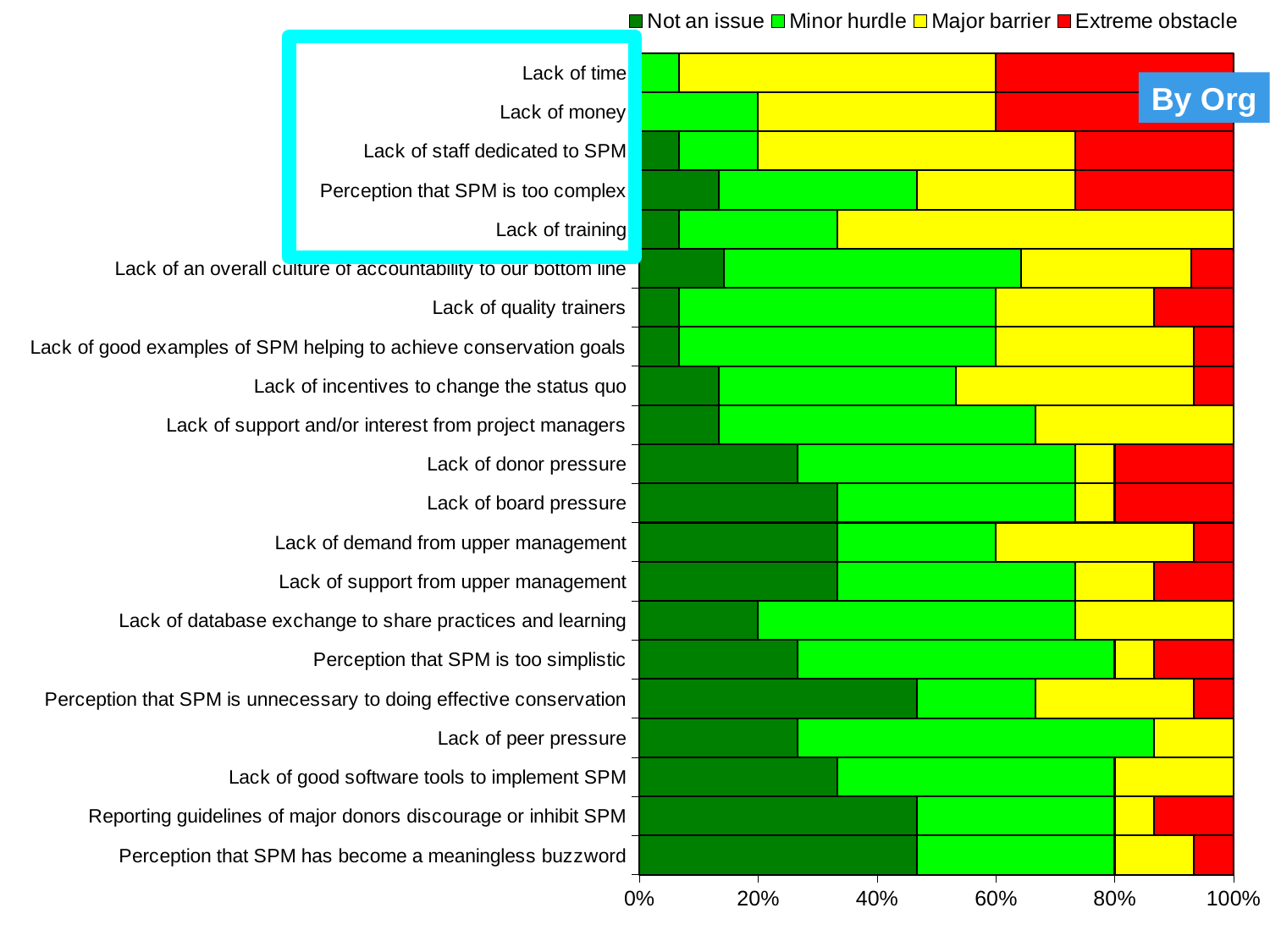
Is the 'Minor hurdle' share for 'Lack of peer pressure' greater or less than 40%? greater Is the 'Extreme obstacle' share for 'Lack of time' greater or less than 20%? greater What are the four response categories listed in the legend? Not an issue, Minor hurdle, Major barrier, Extreme obstacle Which has the larger 'Not an issue' share: 'Lack of time' or 'Perception that SPM has become a meaningless buzzword'? Perception that SPM has become a meaningless buzzword Is the 'Not an issue' share for 'Lack of board pressure' greater or less than 20%? greater What kind of chart is shown on the slide? Stacked bar chart How many series does the legend list? 4 Which has the larger 'Extreme obstacle' share: 'Lack of time' or 'Lack of peer pressure'? Lack of time How many categories (barriers) are plotted on the chart? 21 Which colour represents 'Extreme obstacle' in the chart? Red